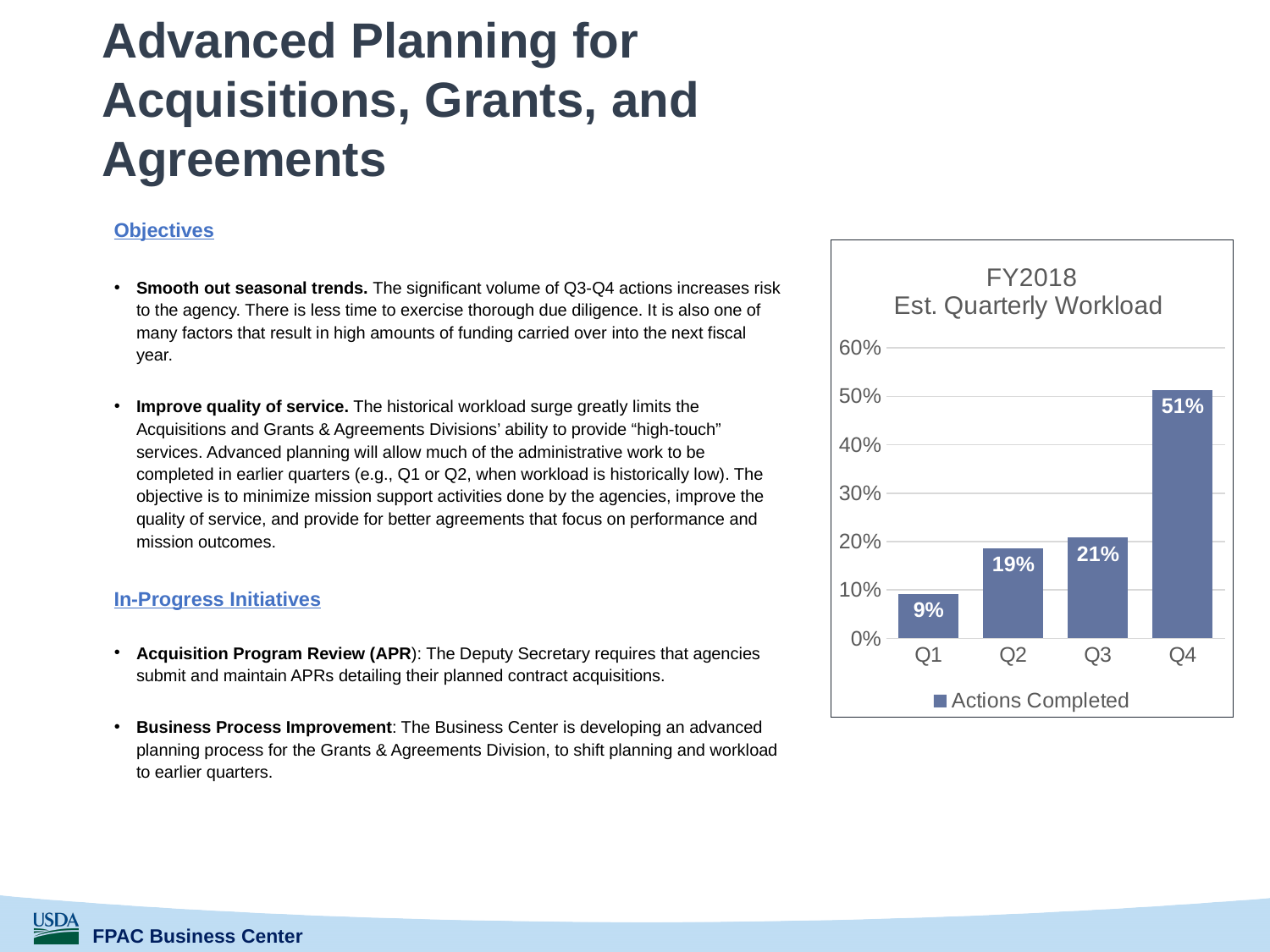
How many quarters are shown in the FY2018 Est. Quarterly Workload chart? 4 Is the value for Q4 in the FY2018 Est. Quarterly Workload chart greater or less than 40%? greater Do the values in the FY2018 Est. Quarterly Workload chart rise or fall from Q1 to Q4? Rise What is the value for Q2 in the FY2018 Est. Quarterly Workload chart? 19% What is the difference between the Q4 and Q3 values in the FY2018 Est. Quarterly Workload chart? 30% Which quarter has the highest value in the FY2018 Est. Quarterly Workload chart? Q4 Which is larger in the FY2018 Est. Quarterly Workload chart, the value for Q2 or the value for Q3? Q3 What is the value for Q1 in the FY2018 Est. Quarterly Workload chart? 9% Which quarter has the lowest value in the FY2018 Est. Quarterly Workload chart? Q1 How many series does the legend of the FY2018 Est. Quarterly Workload chart list? 1 What kind of chart is the FY2018 Est. Quarterly Workload chart? Bar chart What is the value for Q4 in the FY2018 Est. Quarterly Workload chart? 51%